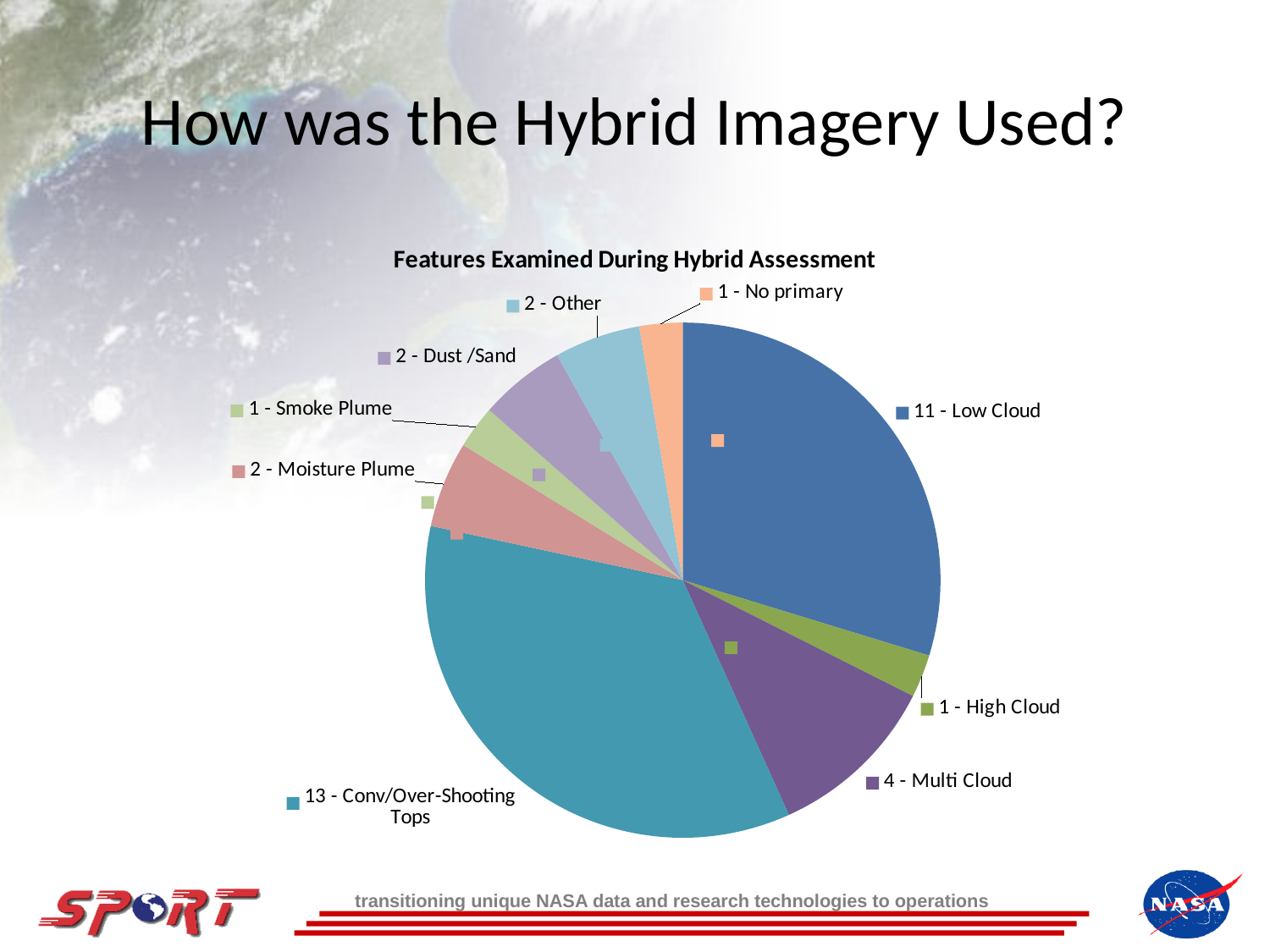
Which feature has the largest slice of the pie? Conv/Over-Shooting Tops What is the value for Moisture Plume? 2 What is the value for Low Cloud? 11 What is the difference between the values for Conv/Over-Shooting Tops and Low Cloud? 2 What is the value for Conv/Over-Shooting Tops? 13 What is the total of all the slice values in the pie chart? 37 Which is larger, the value for Multi Cloud or the value for Dust /Sand? Multi Cloud What is the title of the chart? Features Examined During Hybrid Assessment How many slices does the pie chart have? 9 What is the value for Multi Cloud? 4 What kind of chart is shown on the slide? Pie chart What is the difference between the values for Low Cloud and Multi Cloud? 7